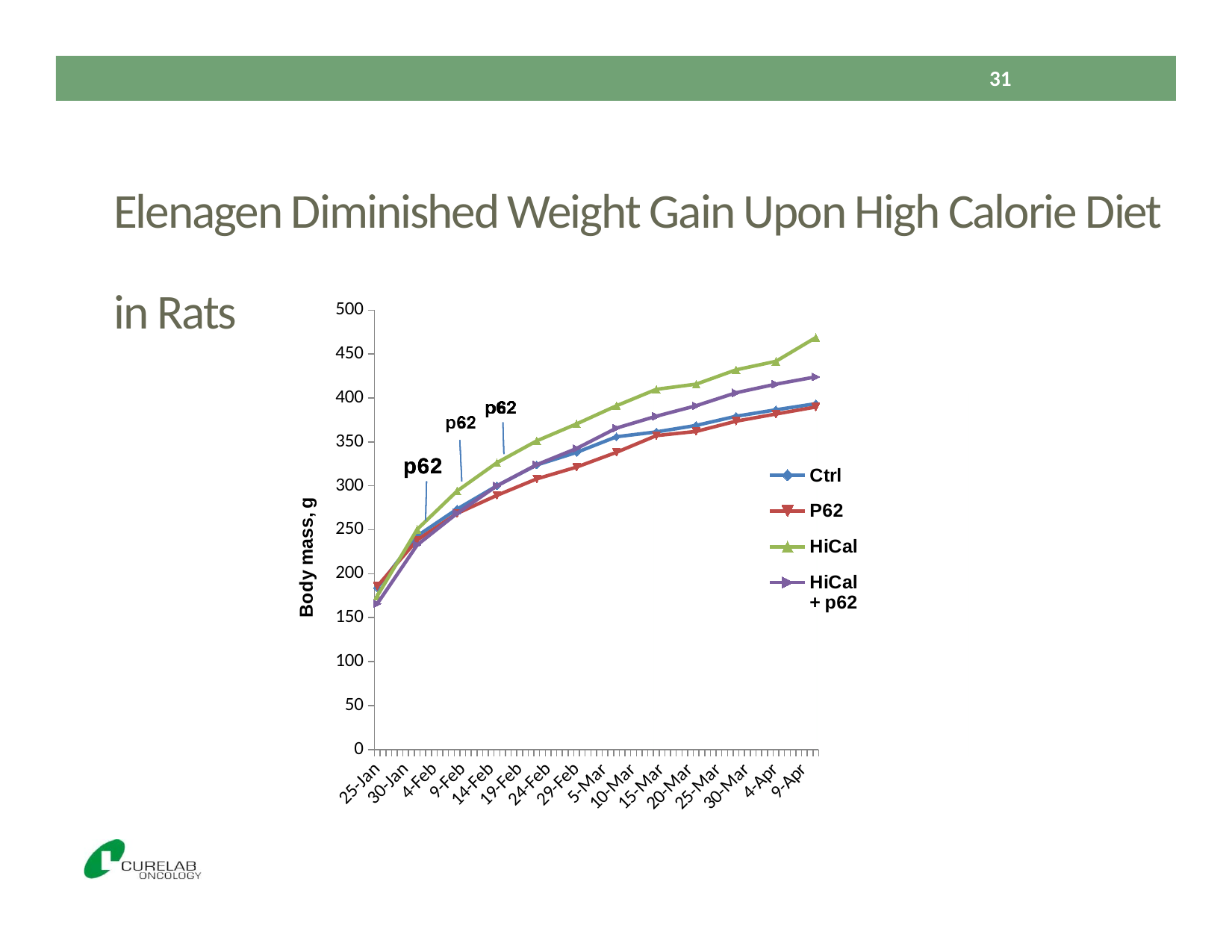
Is the HiCal value at 9-Apr greater or less than 450? greater At 9-Apr, which is larger: the HiCal + p62 value or the Ctrl value? HiCal + p62 How many series does the legend list? 4 Do the body mass values rise or fall from 25-Jan to 9-Apr? Rise Is the HiCal + p62 value at 9-Apr greater or less than 400? greater Is the HiCal value at 5-Mar greater or less than 350? greater At 9-Apr, which is larger: the HiCal value or the P62 value? HiCal What are the series names listed in the legend? Ctrl, P62, HiCal, HiCal + p62 Which series has the highest body mass at 9-Apr? HiCal What is the label of the vertical axis? Body mass, g What kind of chart is shown on the slide? Line chart